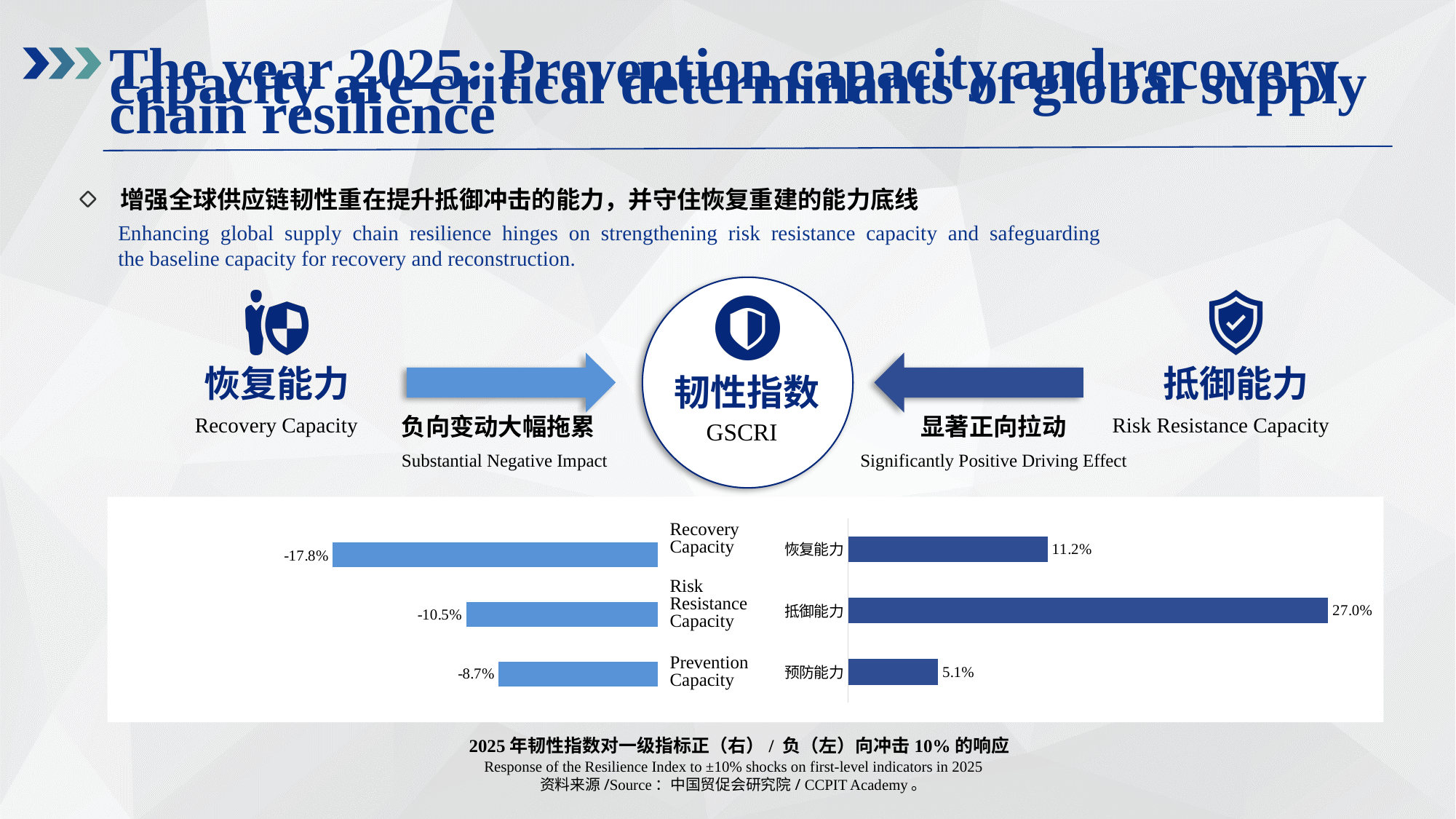
What kind of chart is shown on the slide? Bar chart In the chart, what is the value for Risk Resistance Capacity on the left (negative shock) side? -10.5% In the chart, which category has the largest negative value on the left (negative shock) side? Recovery Capacity In the chart, what is the value for Prevention Capacity on the right (positive shock) side? 5.1% According to the caption, what is the chart's source? CCPIT Academy In the chart, what is the value for Recovery Capacity on the left (negative shock) side? -17.8% In the chart, what is the value for Risk Resistance Capacity on the right (positive shock) side? 27.0% In the chart, which category has the lowest value on the right (positive shock) side? Prevention Capacity In the chart, which category has the highest value on the right (positive shock) side? Risk Resistance Capacity In the chart, what is the difference between the right-side values for Risk Resistance Capacity and Recovery Capacity? 15.8% How many categories are shown in the chart? 3 In the chart, which is larger on the right (positive shock) side: Recovery Capacity or Prevention Capacity? Recovery Capacity